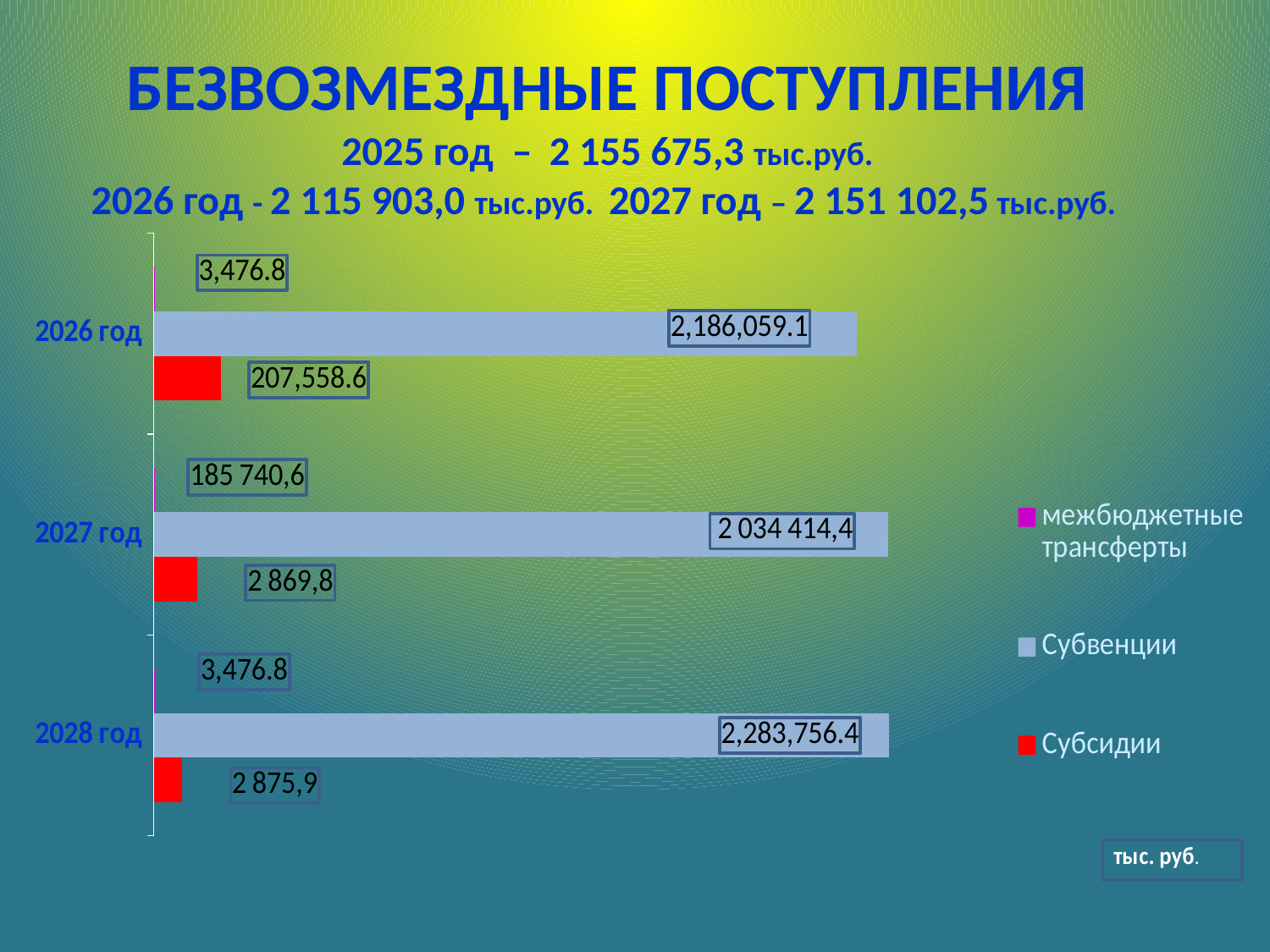
What is the value of Субвенции for 2026 год? 2,186,059.1 How many year categories are shown on the chart? 3 What is the value of межбюджетные трансферты for 2028 год? 3,476.8 What is the value of Субвенции for 2028 год? 2,283,756.4 What is the value of Субсидии for 2026 год? 207,558.6 How many series does the legend list? 3 What is the value of Субвенции for 2027 год? 2 034 414,4 Which year has the highest value for Субвенции? 2028 год What kind of chart is shown on the slide? bar chart Which series is shown in red in the legend? Субсидии